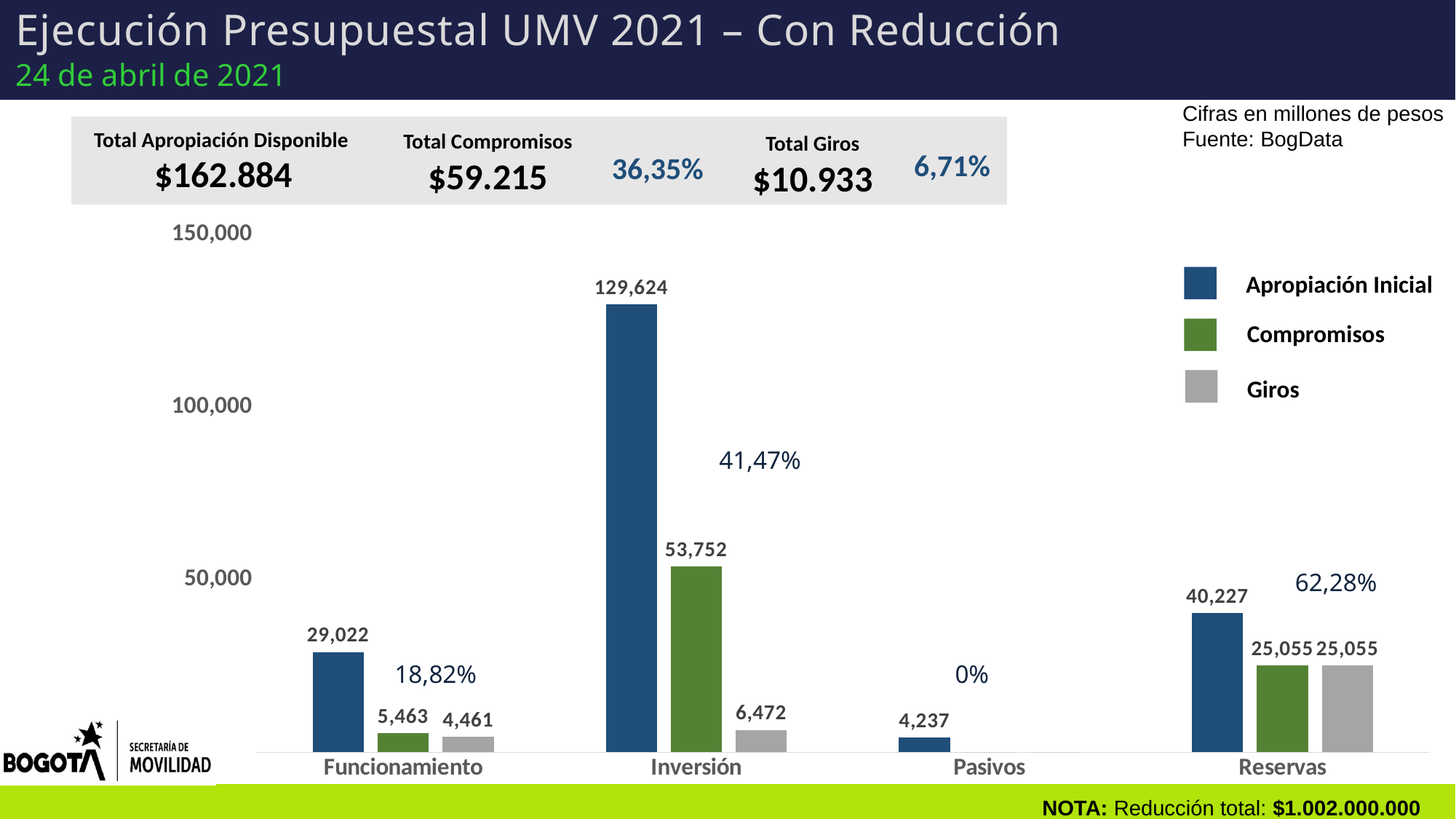
How many series does the legend list? 3 What is the Apropiación Inicial value for Inversión? 129,624 What is the Compromisos value for Funcionamiento? 5,463 What is the Giros value for Reservas? 25,055 What is the Apropiación Inicial value for Pasivos? 4,237 What is the difference between the Apropiación Inicial and Compromisos values for Inversión? 75,872 How many categories are shown on the x axis? 4 Which is larger, the Giros value for Inversión or the Giros value for Funcionamiento? Giros for Inversión Is the Apropiación Inicial value for Reservas greater or less than 50,000? less What kind of chart is shown on the slide? Bar chart Which category has the highest Apropiación Inicial value? Inversión Which category has the lowest Apropiación Inicial value? Pasivos